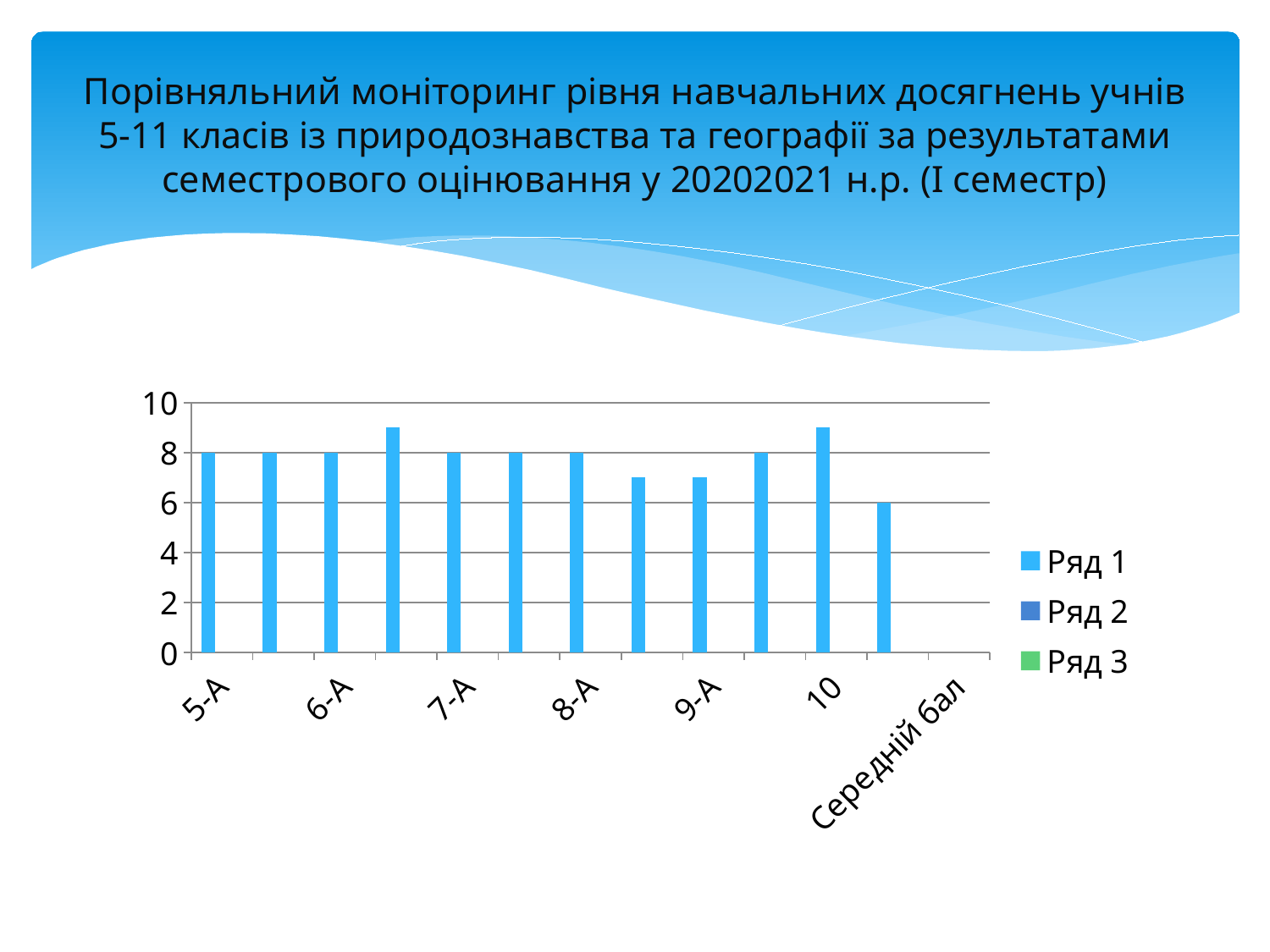
How many bars are plotted on the chart? 12 What is the value for 7-А? 8 Is the value for 10 greater or less than 8? greater Which is larger, the value for 9-А or the value for 10? 10 What is the name of the first series in the legend? Ряд 1 How many series does the legend list? 3 Is the value for 9-А greater or less than 8? less What is the value for 5-А? 8 What type of chart is shown on the slide? bar chart